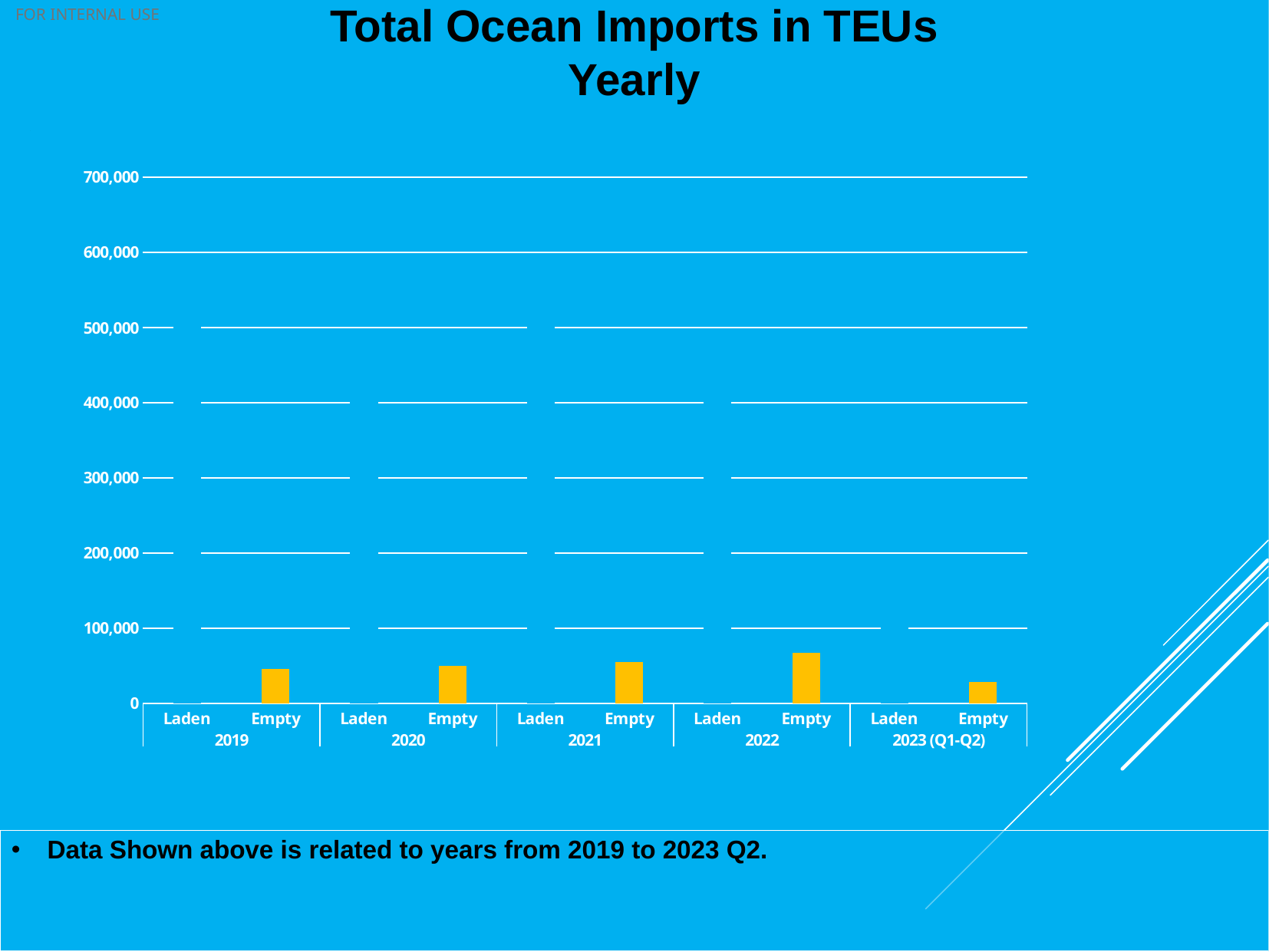
What is the title of the chart? Total Ocean Imports in TEUs Yearly What kind of chart is shown on the slide? bar chart Which is larger, the Empty value for 2022 or the Empty value for 2019? 2022 Is the Empty value for 2023 (Q1-Q2) greater or less than 100,000? less How many year groups are shown on the x axis of the chart? 5 Is the Empty value for 2022 greater or less than 100,000? less What colour are the Empty bars in the chart? yellow Do the Empty values rise or fall from 2019 to 2022? rise Which year group has the lowest Empty bar? 2023 (Q1-Q2) Which is larger, the Empty value for 2021 or the Empty value for 2023 (Q1-Q2)? 2021 How many bars (Laden and Empty) are shown for each year group? 2 Which year has the highest Empty bar? 2022